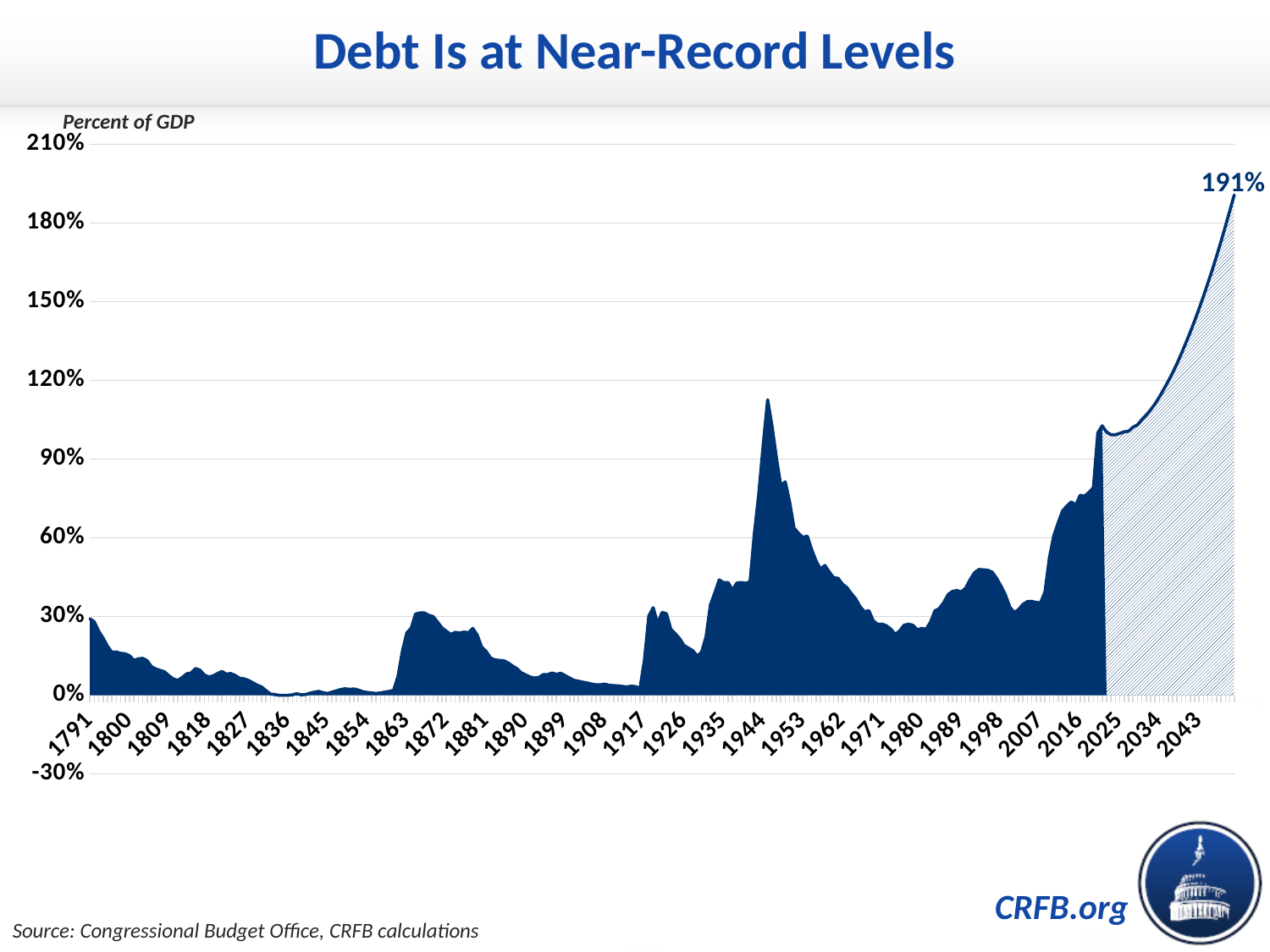
Is the value at the peak around 1944 greater or less than 120%? less Is the value for 1836 greater or less than 30%? less Do the values rise or fall from 2025 to 2043? rise Which is larger, the value at the peak around 1944 or the value in 2016? the peak around 1944 What is the only data value labeled on the chart, at the end of the projection? 191% Is the value for 2016 greater or less than 60%? greater What unit does the y-axis measure, according to the label above it? Percent of GDP What is the highest tick shown on the y-axis? 210% What kind of chart is shown on the slide? area chart What is the title of the chart? Debt Is at Near-Record Levels